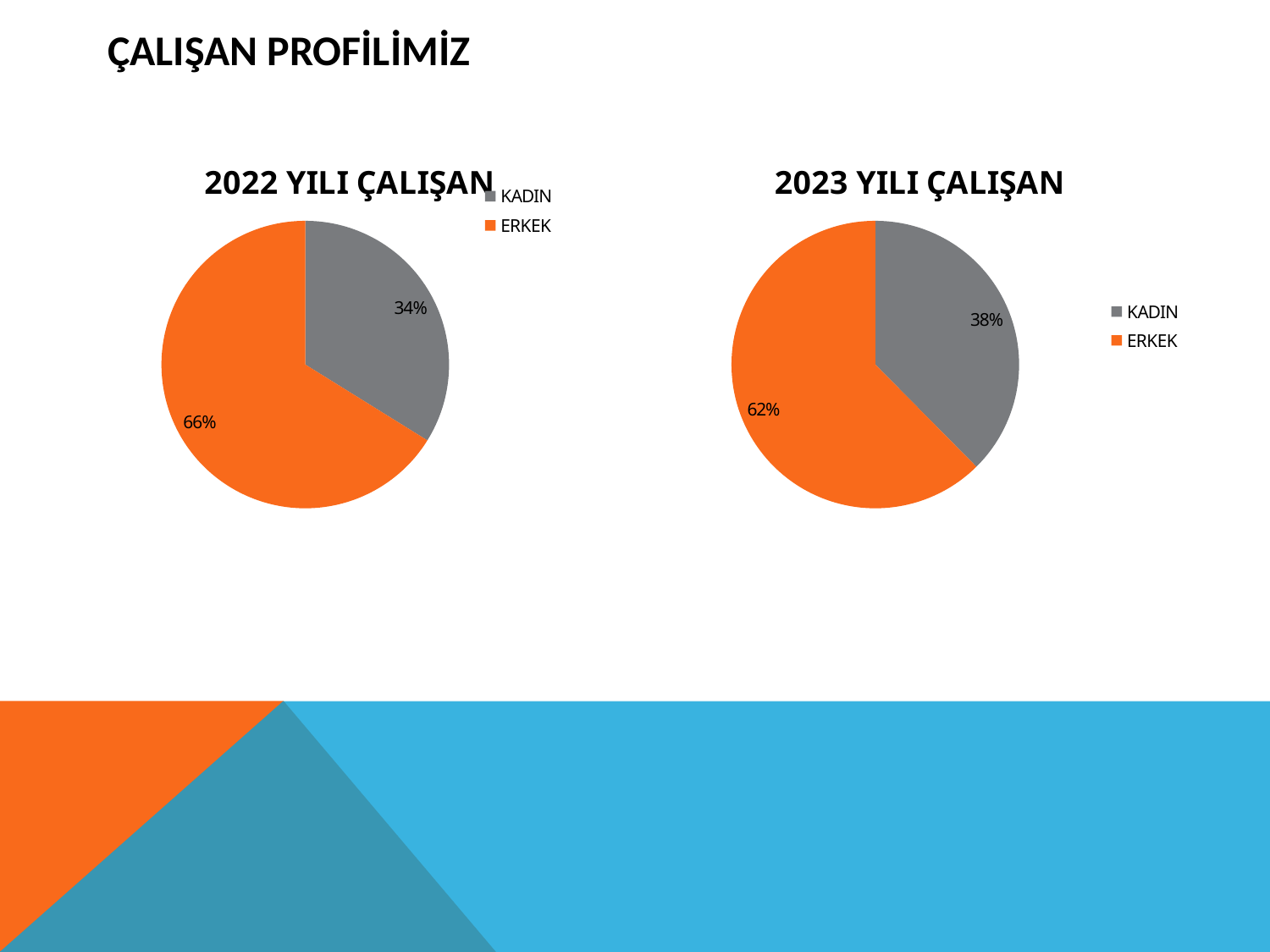
In the "2023 YILI ÇALIŞAN" chart, which colour represents ERKEK? Orange In the "2022 YILI ÇALIŞAN" chart, what share is labelled for ERKEK? 66% In the "2023 YILI ÇALIŞAN" chart, what share is labelled for ERKEK? 62% In the "2022 YILI ÇALIŞAN" chart, what is the difference between the ERKEK and KADIN shares? 32% In the "2023 YILI ÇALIŞAN" chart, what is the difference between the ERKEK and KADIN shares? 24% In the "2022 YILI ÇALIŞAN" chart, which category has the largest slice? ERKEK In the "2023 YILI ÇALIŞAN" chart, which category has the smallest slice? KADIN How many slices does the "2022 YILI ÇALIŞAN" pie chart have? 2 Is the KADIN share larger in the "2022 YILI ÇALIŞAN" chart or the "2023 YILI ÇALIŞAN" chart? 2023 YILI ÇALIŞAN What type of chart is the "2023 YILI ÇALIŞAN" chart? Pie chart In the "2022 YILI ÇALIŞAN" chart, what share is labelled for KADIN? 34% In the "2023 YILI ÇALIŞAN" chart, what share is labelled for KADIN? 38%